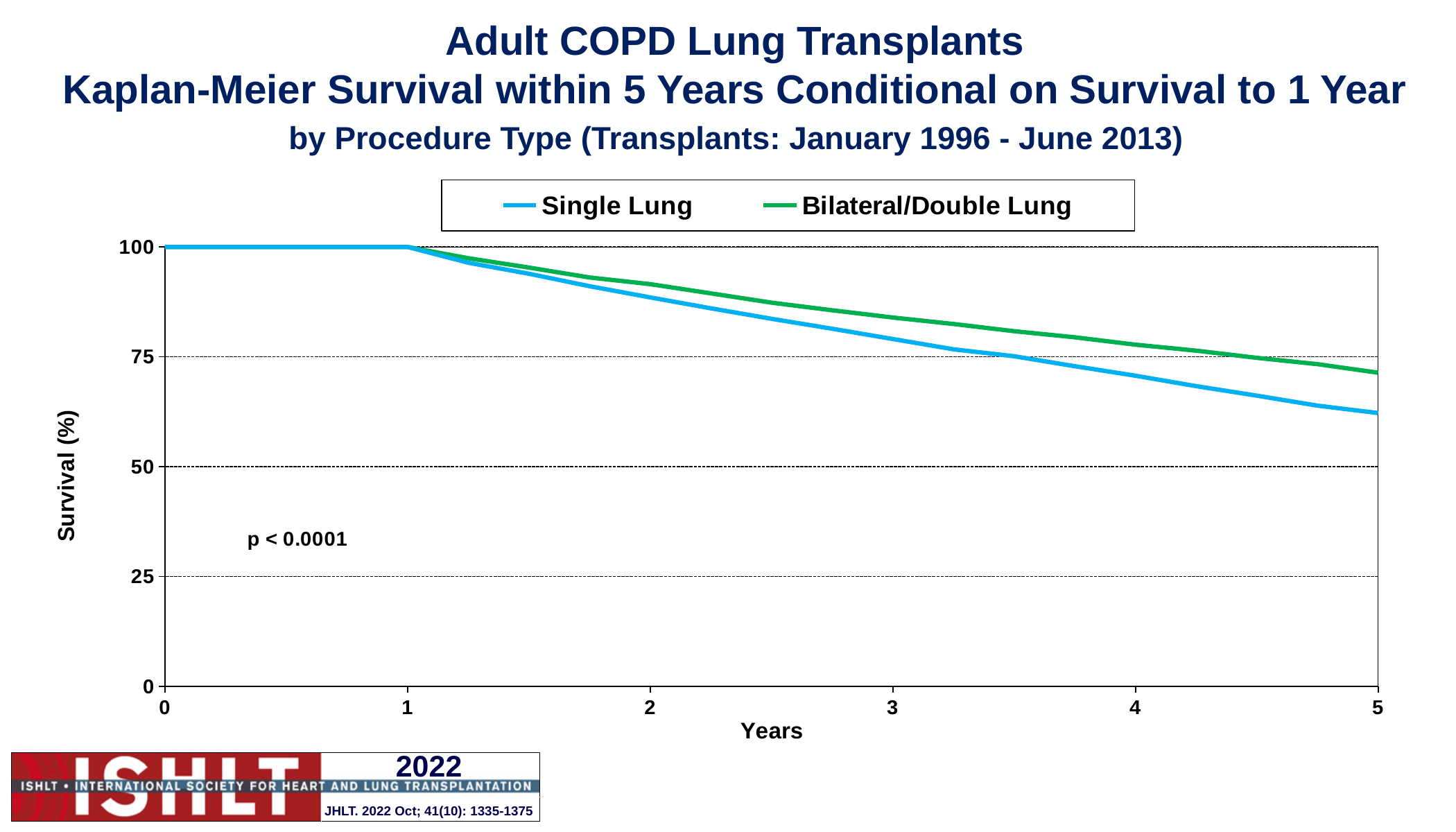
Which series is shown in green in the legend? Bilateral/Double Lung What is the survival (%) for Single Lung at 1 year? 100 What kind of chart is shown on the slide? Line chart Is the survival for Bilateral/Double Lung at 5 years greater or less than 50? greater What is the survival (%) for Bilateral/Double Lung at 1 year? 100 Do the survival curves rise or fall as years increase from 1 to 5? Fall How many series does the legend list? 2 At 5 years, which series has the higher survival, Single Lung or Bilateral/Double Lung? Bilateral/Double Lung Is the survival for Single Lung at 3 years greater or less than 75? greater What p-value is printed on the chart? p < 0.0001 Is the survival for Single Lung at 5 years greater or less than 75? less